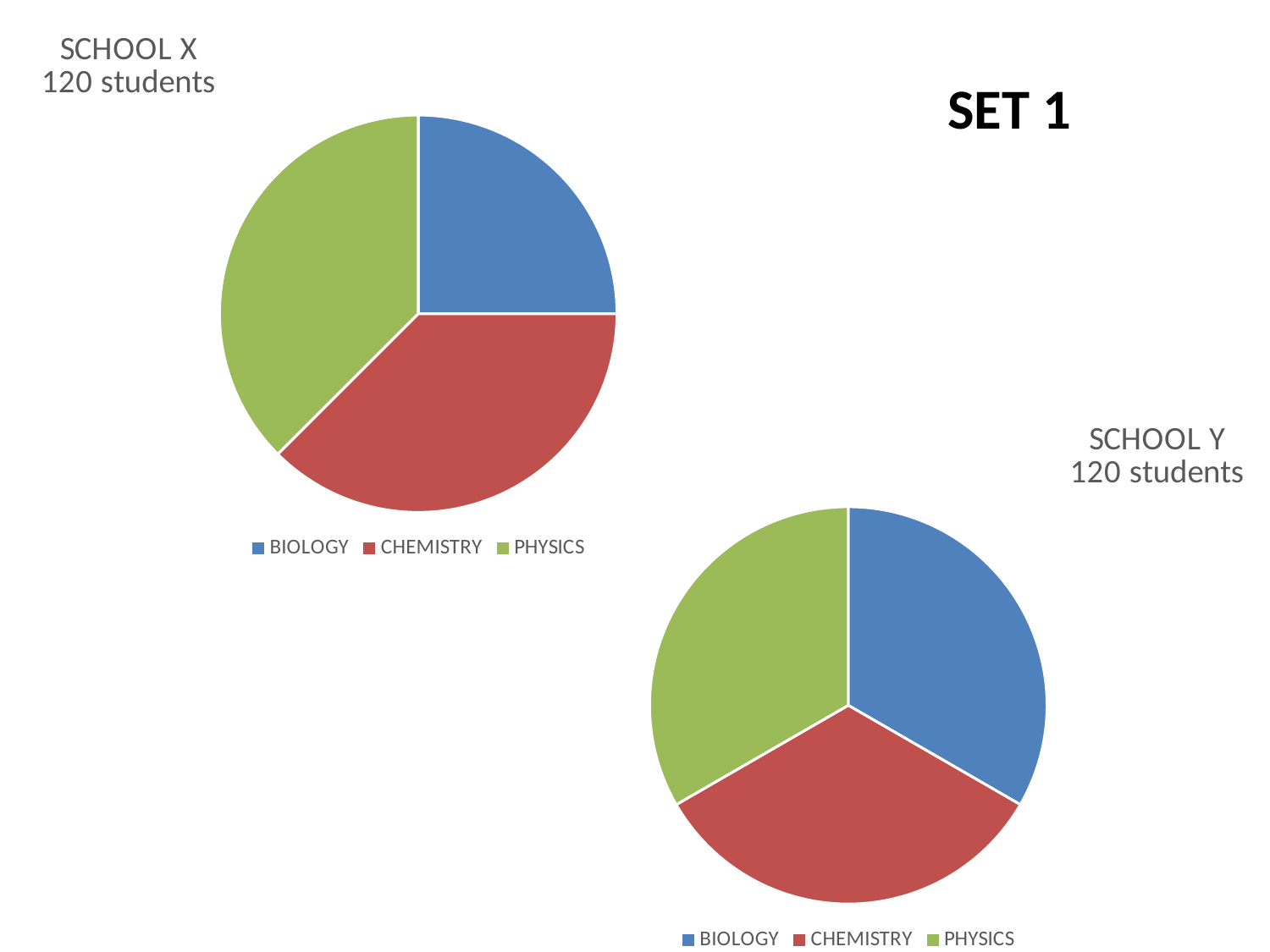
How many slices does the School Y pie chart have? 3 In the School X chart, which slice is larger, Biology or Physics? Physics How many entries does the legend of the School X chart list? 3 What kind of chart is the School X chart? pie chart In the School X chart, which slice is larger, Biology or Chemistry? Chemistry How many entries does the legend of the School Y chart list? 3 What are the legend entries of the School Y chart? Biology, Chemistry, Physics What kind of chart is the School Y chart? pie chart In the School X chart, which subject has the smallest slice? Biology How many slices does the School X pie chart have? 3 In the School X chart, which colour represents Chemistry? red